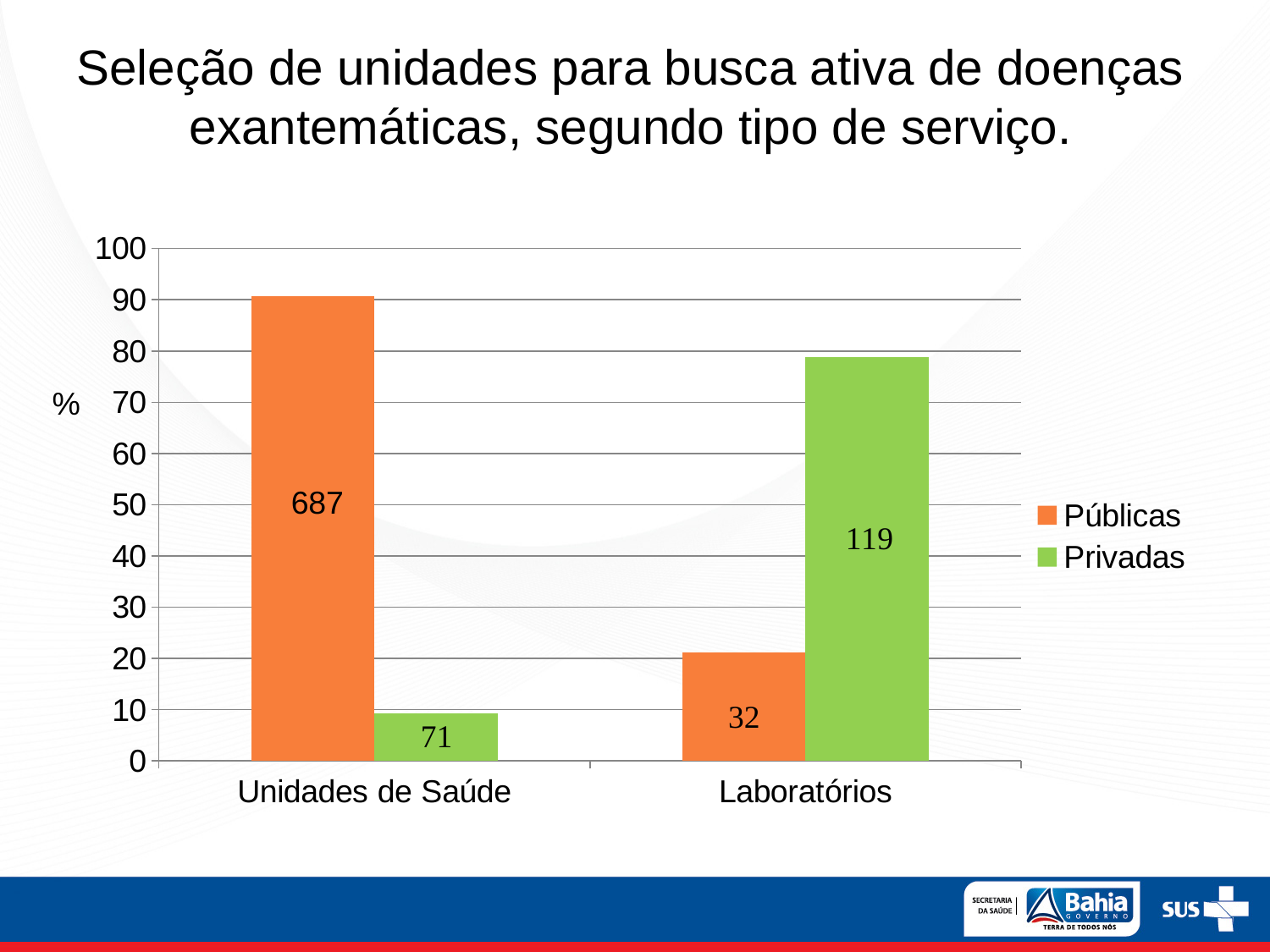
What data label is printed on the Públicas bar for Unidades de Saúde? 687 How many categories are shown on the x axis? 2 Is the percentage for Privadas in Laboratórios greater or less than 70? greater What kind of chart is shown on the slide? bar chart Which bar is the tallest in the chart? Públicas, Unidades de Saúde How many series does the legend list? 2 Is the percentage for Públicas in Unidades de Saúde greater or less than 80? greater What data label is printed on the Públicas bar for Laboratórios? 32 What data label is printed on the Privadas bar for Unidades de Saúde? 71 What data label is printed on the Privadas bar for Laboratórios? 119 Which bar is the shortest in the chart? Privadas, Unidades de Saúde Which colour represents the Privadas series in the legend? green